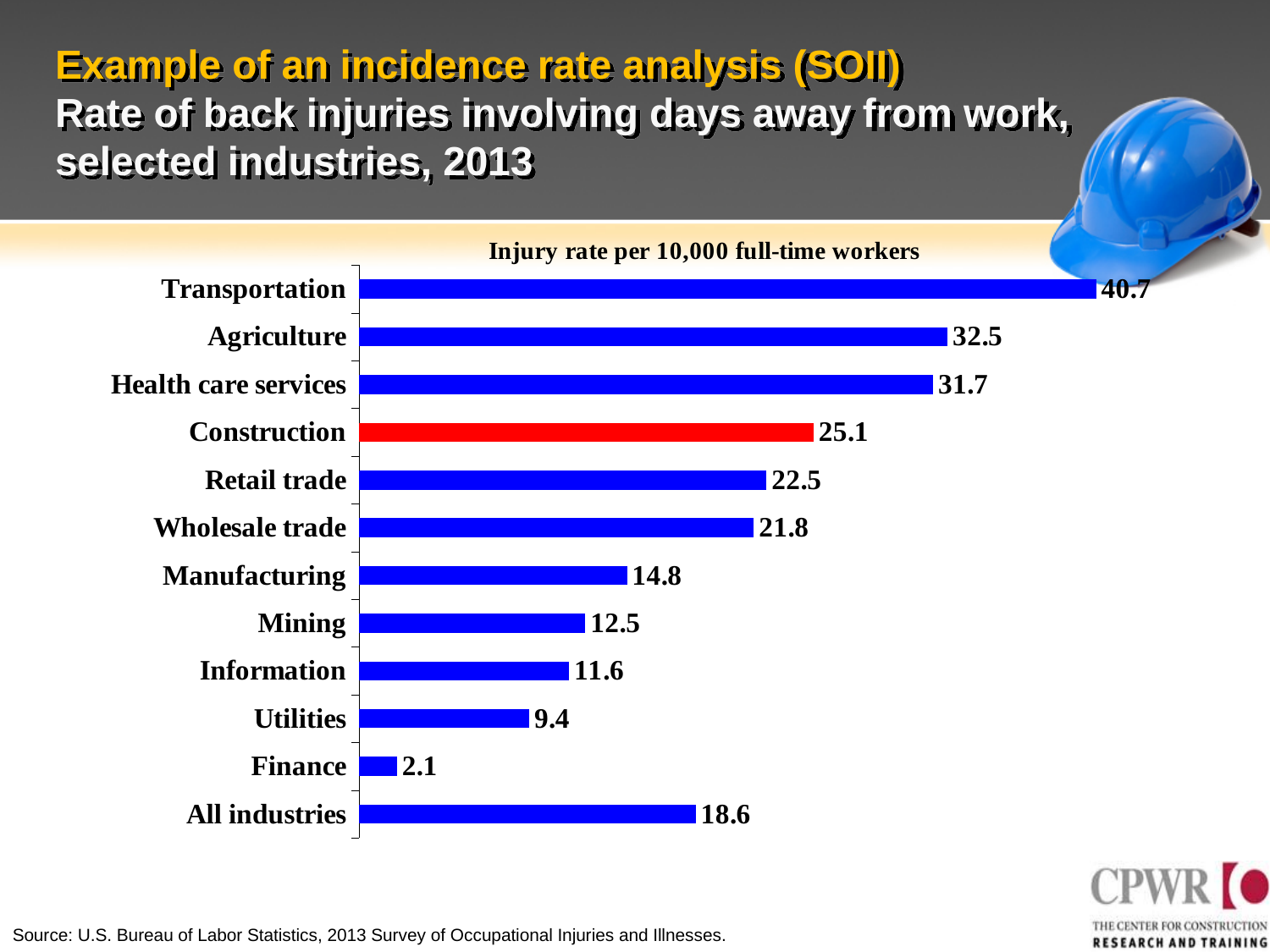
How many categories (bars) are shown in the chart? 12 Which has a higher injury rate, Agriculture or Health care services? Agriculture What kind of chart is shown on the slide? Bar chart What is the injury rate per 10,000 full-time workers for Construction? 25.1 Which industry has the highest injury rate? Transportation What is the difference between the injury rates for Construction and All industries? 6.5 Which industry has the lowest injury rate? Finance What is the injury rate per 10,000 full-time workers for Mining? 12.5 Which has a higher injury rate, Manufacturing or Wholesale trade? Wholesale trade Which bar is coloured red rather than blue? Construction What is the injury rate per 10,000 full-time workers for All industries? 18.6 What is the difference between the injury rates for Transportation and Construction? 15.6